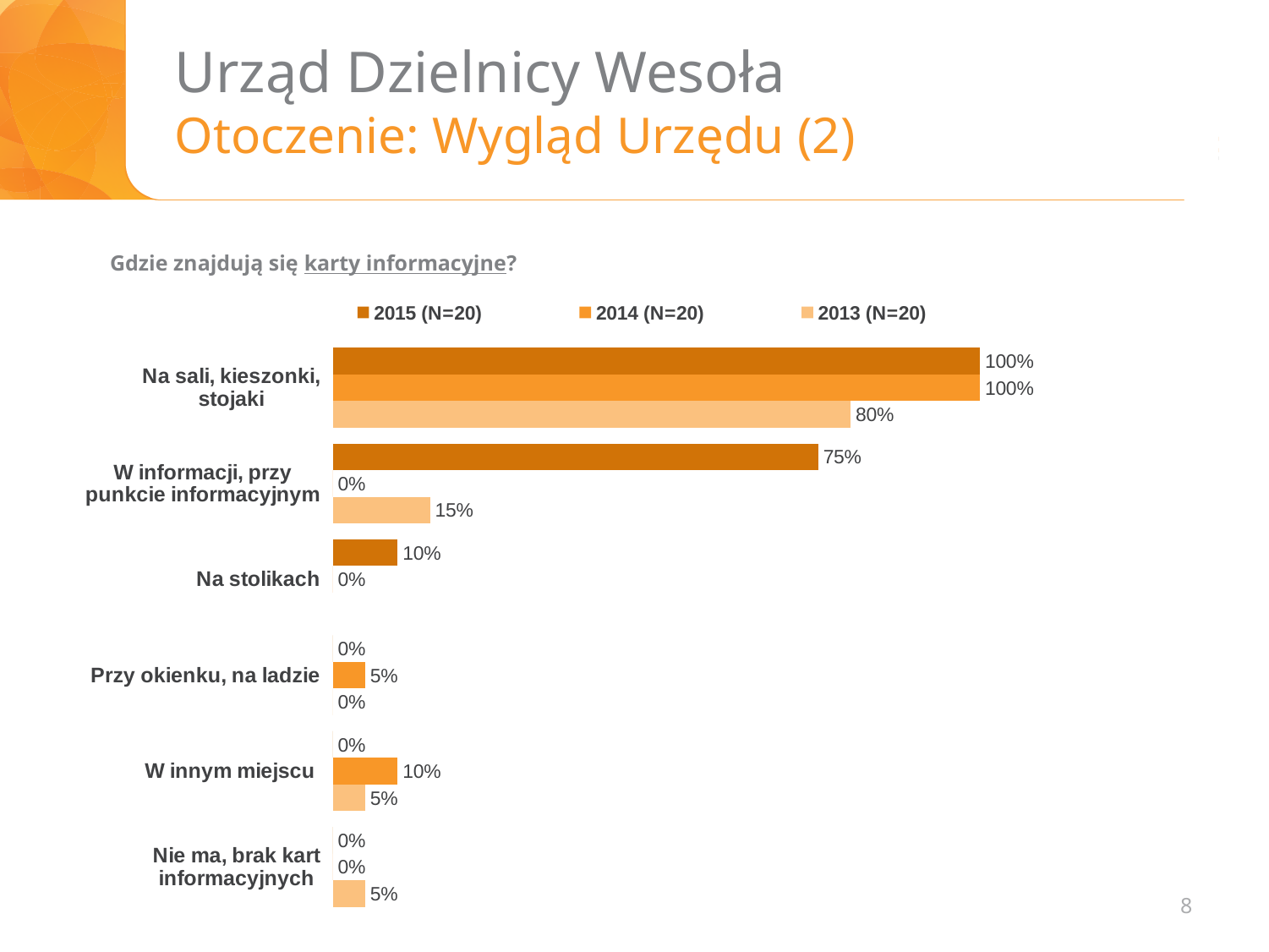
What is the value for 'Na sali, kieszonki, stojaki' in 2013 (N=20)? 80% Which category has the highest value for 2015 (N=20)? Na sali, kieszonki, stojaki What kind of chart is shown on the slide? bar chart Which is larger for 'Przy okienku, na ladzie': the 2014 (N=20) value or the 2013 (N=20) value? 2014 (N=20) What is the difference between the 2014 (N=20) and 2013 (N=20) values for 'Na sali, kieszonki, stojaki'? 20% What question does the chart's title ask? Gdzie znajdują się karty informacyjne? What is the value for 'W innym miejscu' in 2014 (N=20)? 10% How many categories are shown on the chart? 6 What is the difference between the 2015 (N=20) and 2013 (N=20) values for 'W informacji, przy punkcie informacyjnym'? 60% What is the value for 'Nie ma, brak kart informacyjnych' in 2013 (N=20)? 5% What is the value for 'W informacji, przy punkcie informacyjnym' in 2015 (N=20)? 75% How many series does the legend list? 3